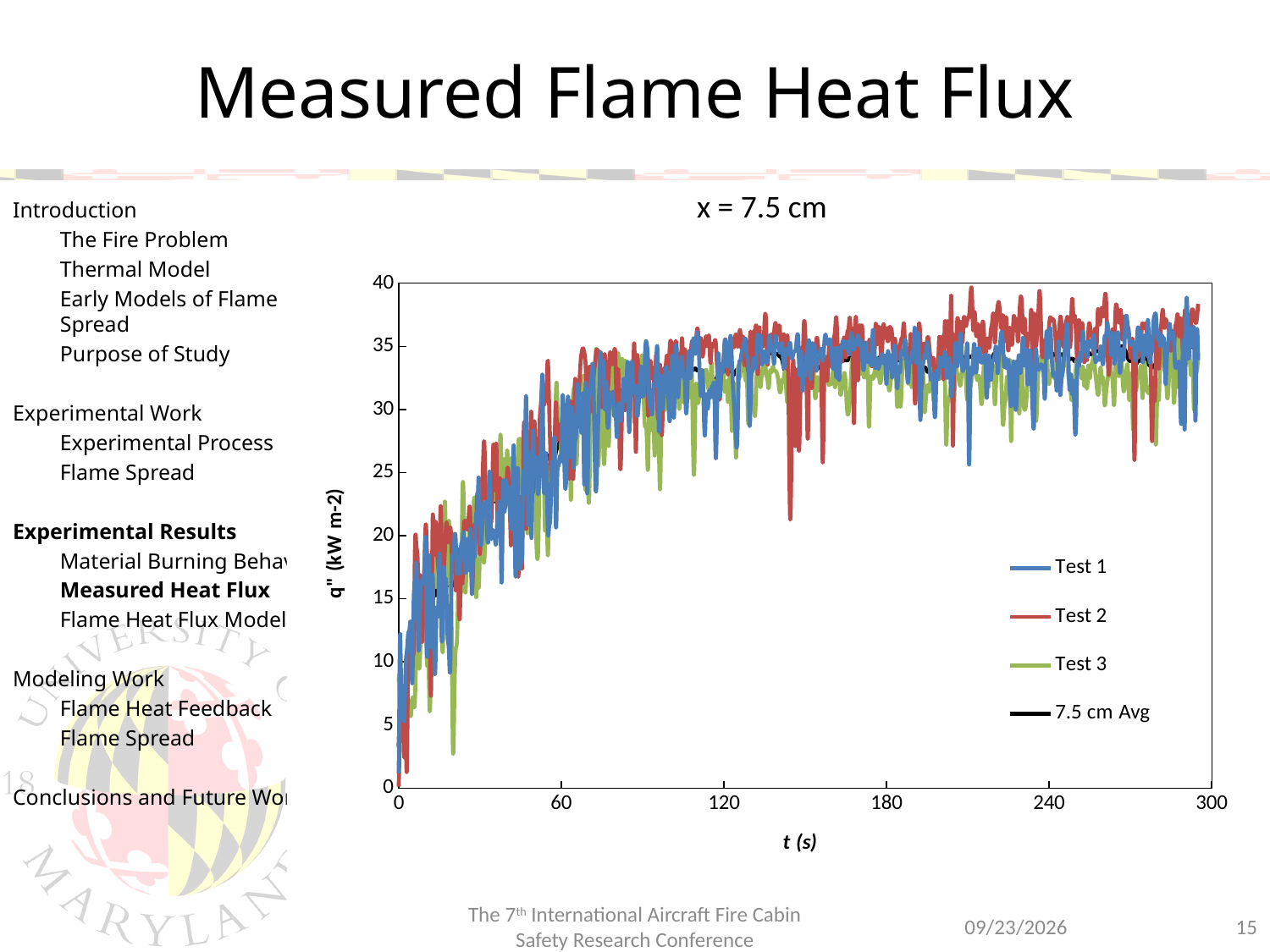
What kind of chart is shown on the slide? line chart How many series does the chart legend list? 4 Is the value for Test 1 at t = 60 s greater or less than 40? less Is the value for Test 2 at t = 240 s greater or less than 30? greater Which series is drawn in black in the chart? 7.5 cm Avg Do the heat flux values generally rise or fall as t increases from 0 to 60 s? rise Is the value for Test 3 at t = 180 s greater or less than 25? greater Which series has the highest values in the last part of the chart (after t = 240 s)? Test 2 What is the title of the chart? x = 7.5 cm Around t = 240 s, which series has the larger value, Test 2 or Test 3? Test 2 What is the label of the x axis of the chart? t (s)